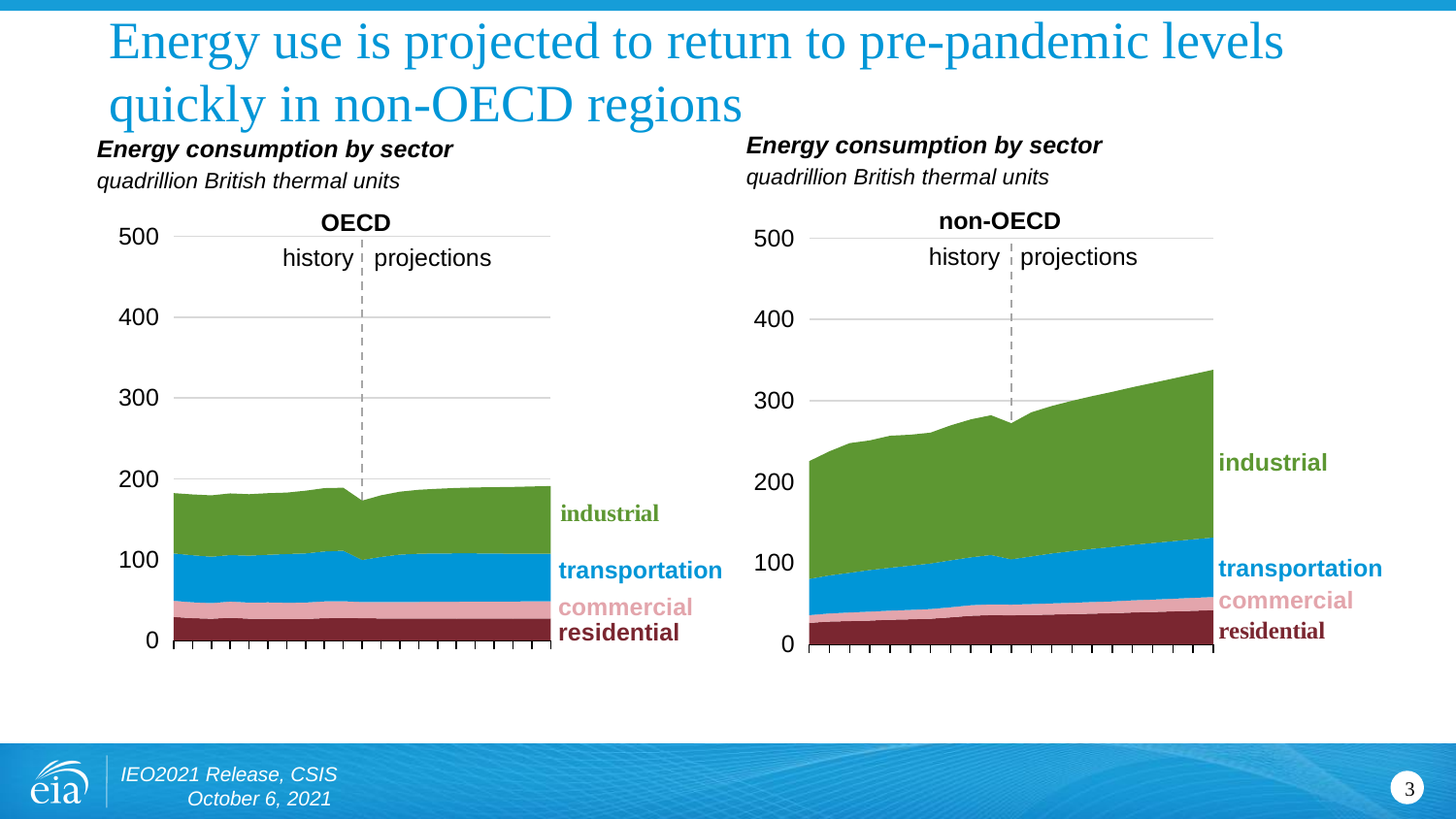
What unit is energy consumption measured in on both charts? quadrillion British thermal units Which chart shows higher total energy consumption at the end of the projection period, OECD or non-OECD? non-OECD In the non-OECD chart, which sector accounts for the largest share of energy consumption? industrial In the OECD chart, is total energy consumption at the end of the projection period greater or less than 200? less In the non-OECD chart, does total energy consumption rise or fall over the projection period? rise What does the vertical dashed line in each chart separate? history and projections How many sectors (series) are shown in the non-OECD chart? 4 What kind of chart is the OECD chart on the left? stacked area chart In the OECD chart, which sector accounts for the largest share of energy consumption? industrial In the non-OECD chart, is total energy consumption at the start of the history period greater or less than 200? greater In the non-OECD chart, which sector accounts for the smallest share of energy consumption? commercial In the non-OECD chart, is total energy consumption at the end of the projection period greater or less than 300? greater